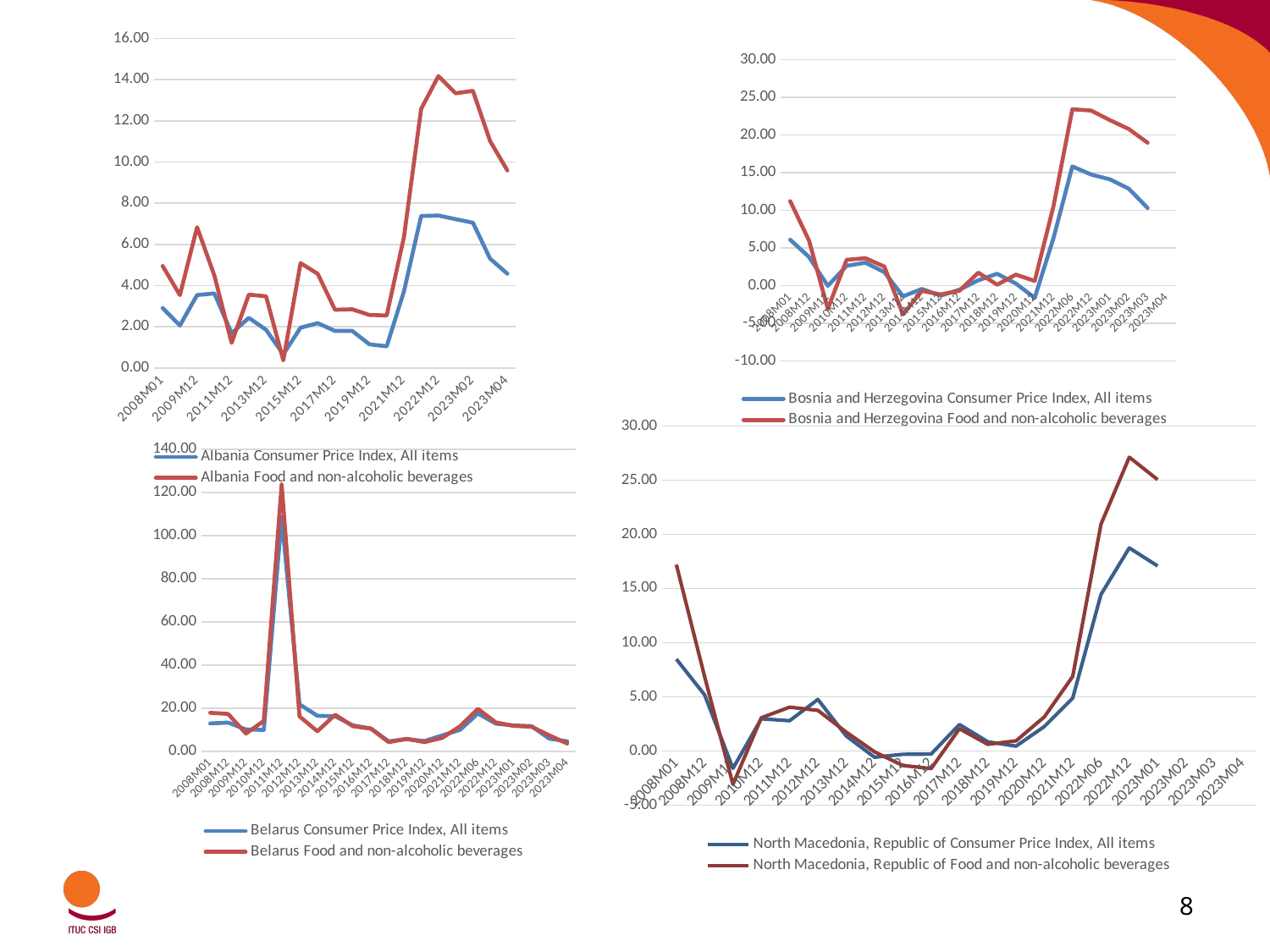
In the North Macedonia chart, is the highest value of the North Macedonia, Republic of Consumer Price Index, All items series greater or less than 20.00? less How many series does the legend of the Belarus chart list? 2 In the Albania chart, is the highest value of the Albania Consumer Price Index, All items series greater or less than 8.00? less In the Albania chart, which series is higher at 2022M12: Albania Consumer Price Index, All items or Albania Food and non-alcoholic beverages? Albania Food and non-alcoholic beverages In the Albania chart, is the peak value of the Albania Food and non-alcoholic beverages series greater or less than 12.00? greater What kind of chart is the Albania chart at the top left of the slide? line chart In the Albania chart, what colour is the line for Albania Consumer Price Index, All items? blue In the Albania chart, does the Albania Food and non-alcoholic beverages series rise or fall from 2022M12 to 2023M04? fall